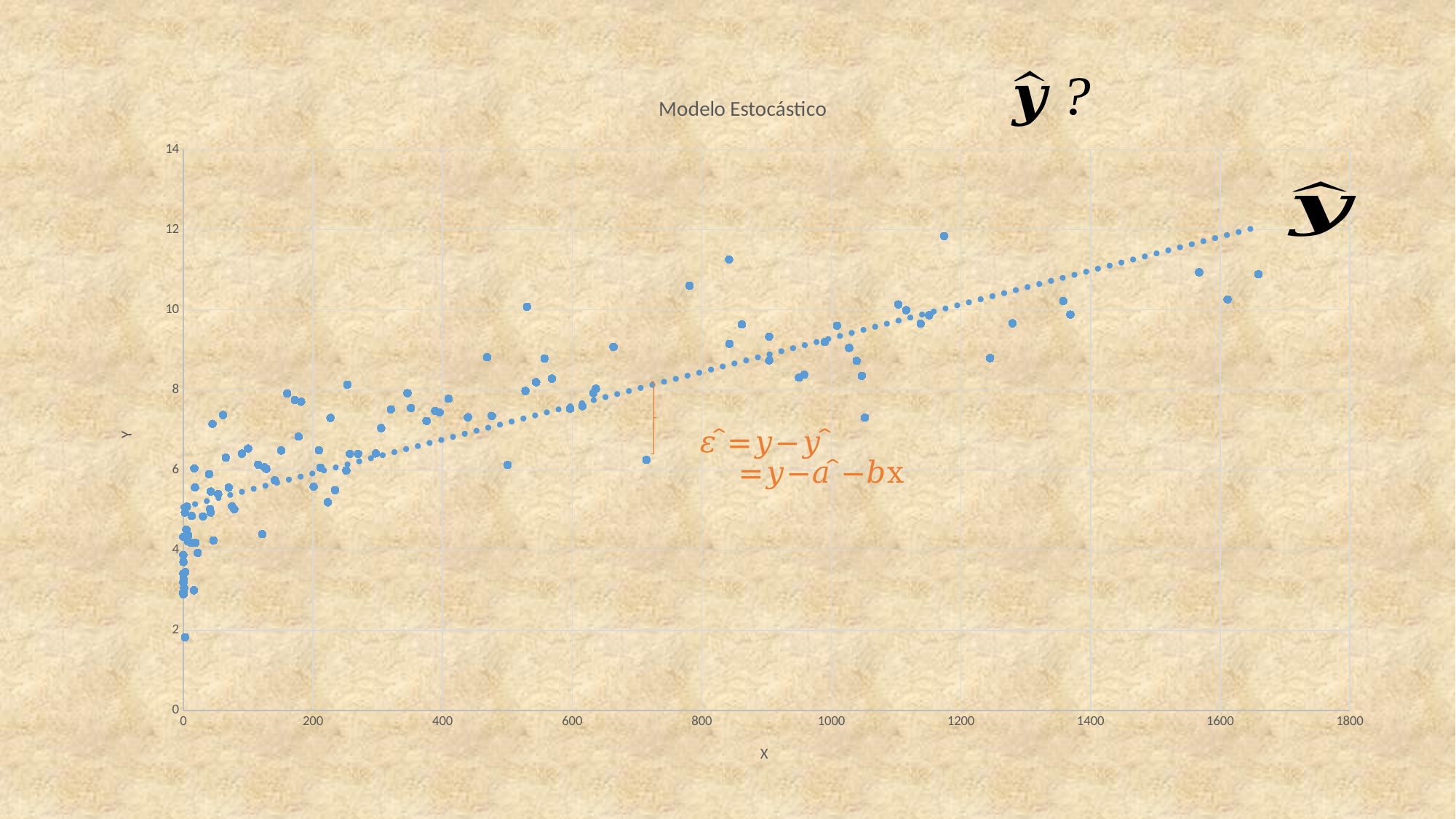
Do the plotted Y values generally rise or fall as X increases? Rise What is the highest tick value shown on the Y axis? 14 What kind of chart is shown on the slide? Scatter plot Is the Y value of the dotted trend line at X = 1600 greater or less than 10? greater Is the Y value of the lowest plotted point greater or less than 2? less Does the dotted trend line slope upward or downward from left to right? Upward What is the label of the horizontal axis of the chart? X Is the Y value of the highest plotted point greater or less than 11? greater What is the highest tick value shown on the X axis? 1800 What is the title of the chart? Modelo Estocástico